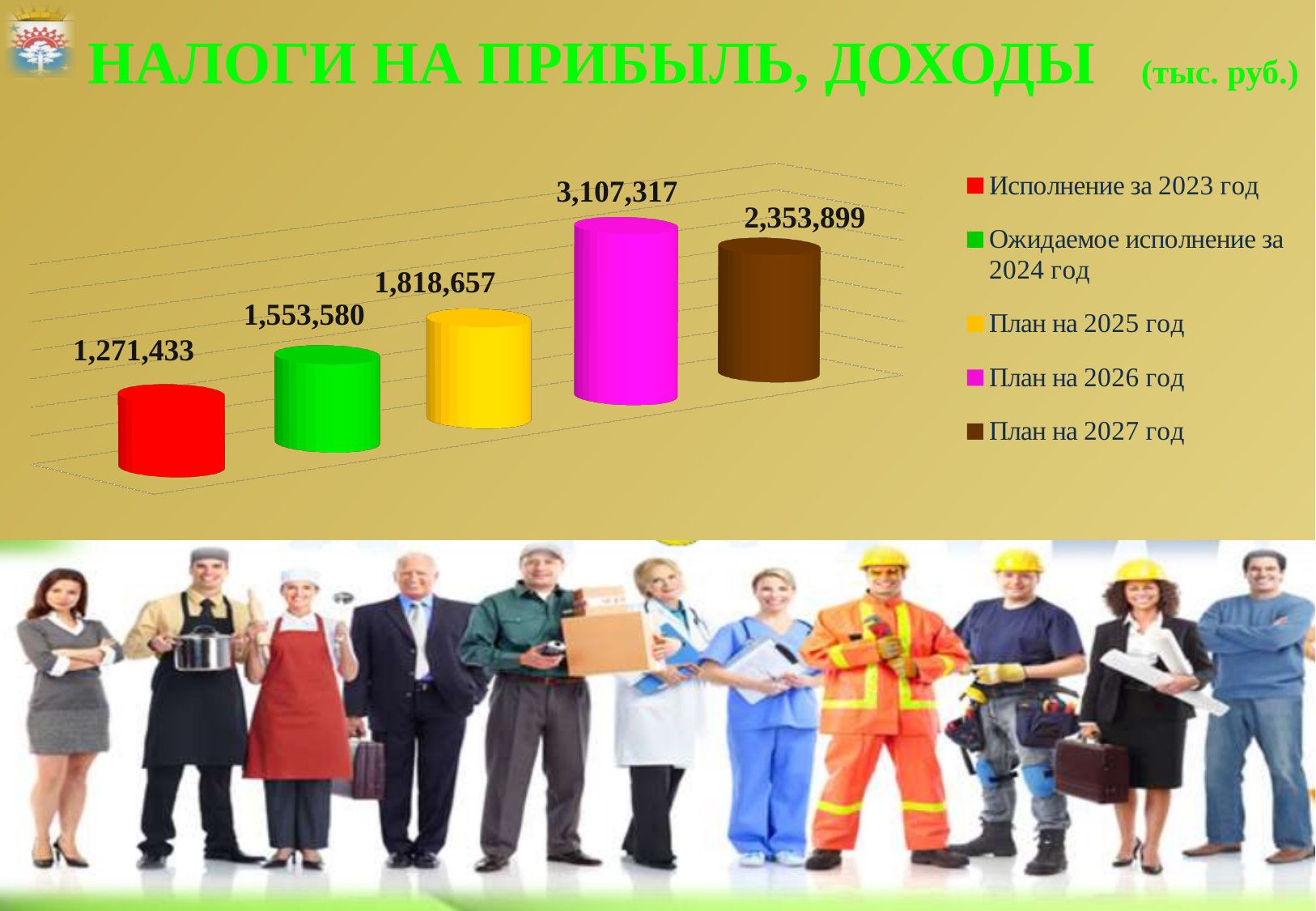
What is the value for «План на 2026 год»? 3,107,317 What is the value for «Исполнение за 2023 год»? 1,271,433 Which series has the lowest value? Исполнение за 2023 год Which is larger: the value for «План на 2025 год» or the value for «Ожидаемое исполнение за 2024 год»? План на 2025 год How many series does the legend list? 5 What unit is given in the chart title? тыс. руб. What is the difference between the value for «План на 2026 год» and the value for «План на 2027 год»? 753,418 What is the value for «План на 2027 год»? 2,353,899 What is the value for «План на 2025 год»? 1,818,657 What is the value for «Ожидаемое исполнение за 2024 год»? 1,553,580 What kind of chart is shown on the slide? Bar chart Which series has the highest value? План на 2026 год